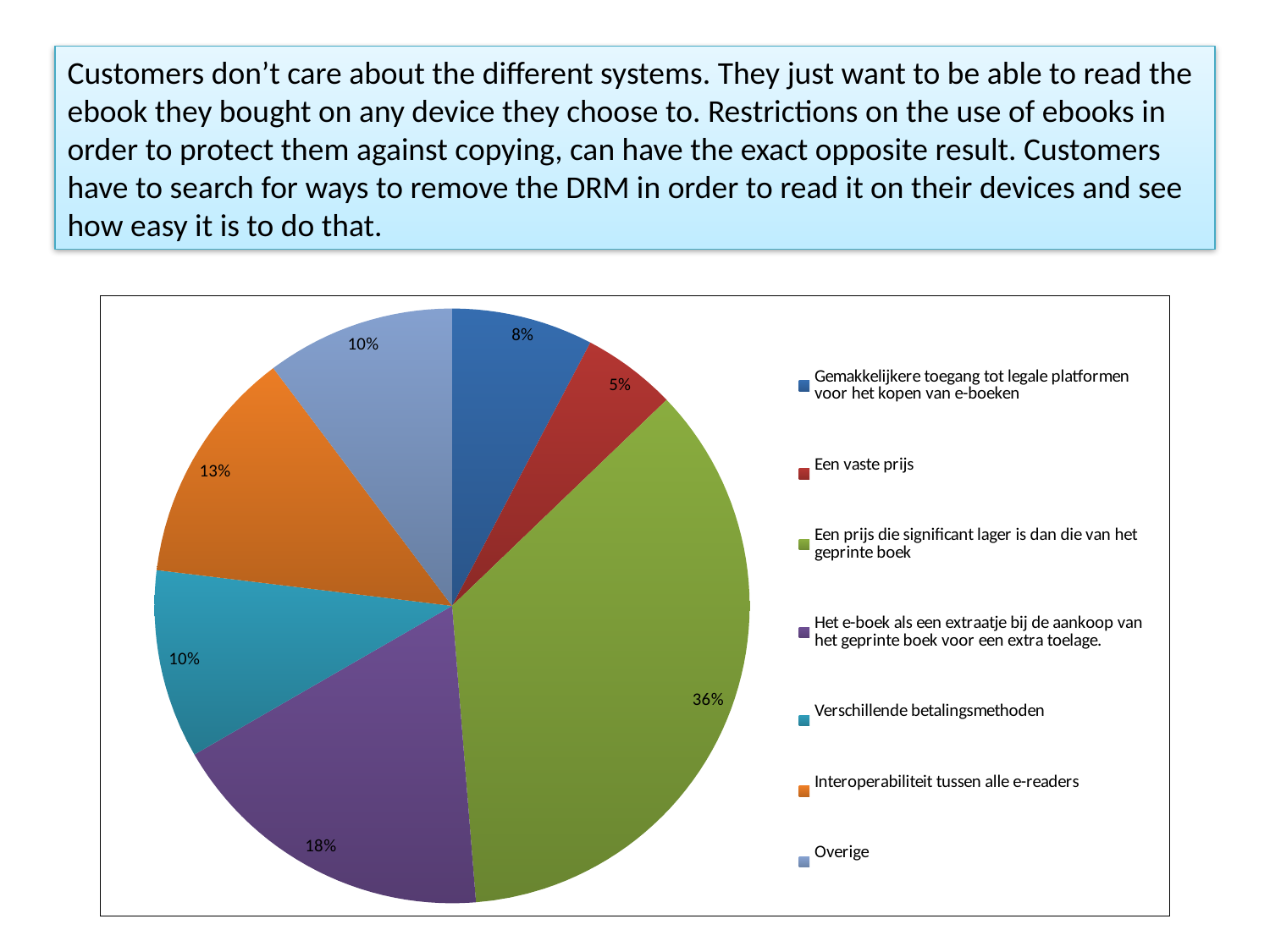
What kind of chart is shown on the slide? pie chart Which category has the largest slice of the pie? Een prijs die significant lager is dan die van het geprinte boek Which category has the smallest slice of the pie? Een vaste prijs What share of the pie does "Interoperabiliteit tussen alle e-readers" have? 13% What colour is the slice for "Overige" in the pie chart? light blue What is the difference in percentage points between "Een prijs die significant lager is dan die van het geprinte boek" and "Het e-boek als een extraatje bij de aankoop van het geprinte boek voor een extra toelage."? 18 percentage points How many slices does the pie chart have? 7 What share of the pie does "Het e-boek als een extraatje bij de aankoop van het geprinte boek voor een extra toelage." have? 18% What share of the pie does "Een vaste prijs" have? 5% Which is larger: the slice for "Interoperabiliteit tussen alle e-readers" or the slice for "Verschillende betalingsmethoden"? Interoperabiliteit tussen alle e-readers